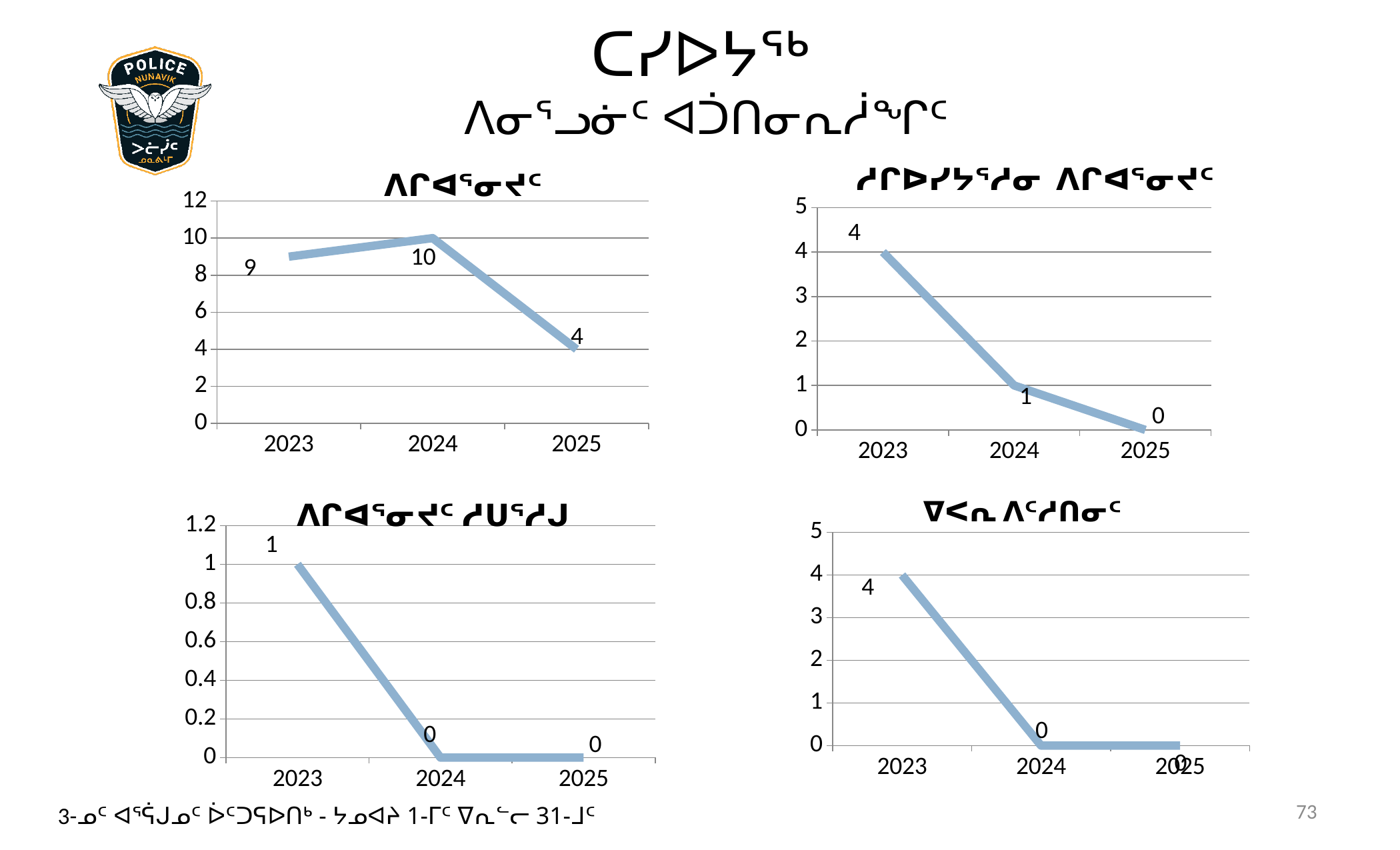
In the top-right chart, what is the value for 2024? 1 In the top-left chart, which year has the highest value? 2024 In the bottom-right chart, what is the value for 2023? 4 In the top-right chart, what is the value for 2023? 4 In the top-left chart, what is the difference between the 2024 and 2025 values? 6 In the top-left chart, what is the value for 2025? 4 In the bottom-left chart, which year has the highest value? 2023 In the top-right chart, do the values rise or fall from 2023 to 2025? fall In the bottom-left chart, what is the value for 2023? 1 What type of chart is the top-left chart? line chart In the bottom-right chart, how many years are plotted on the x axis? 3 In the top-left chart, what is the value for 2024? 10